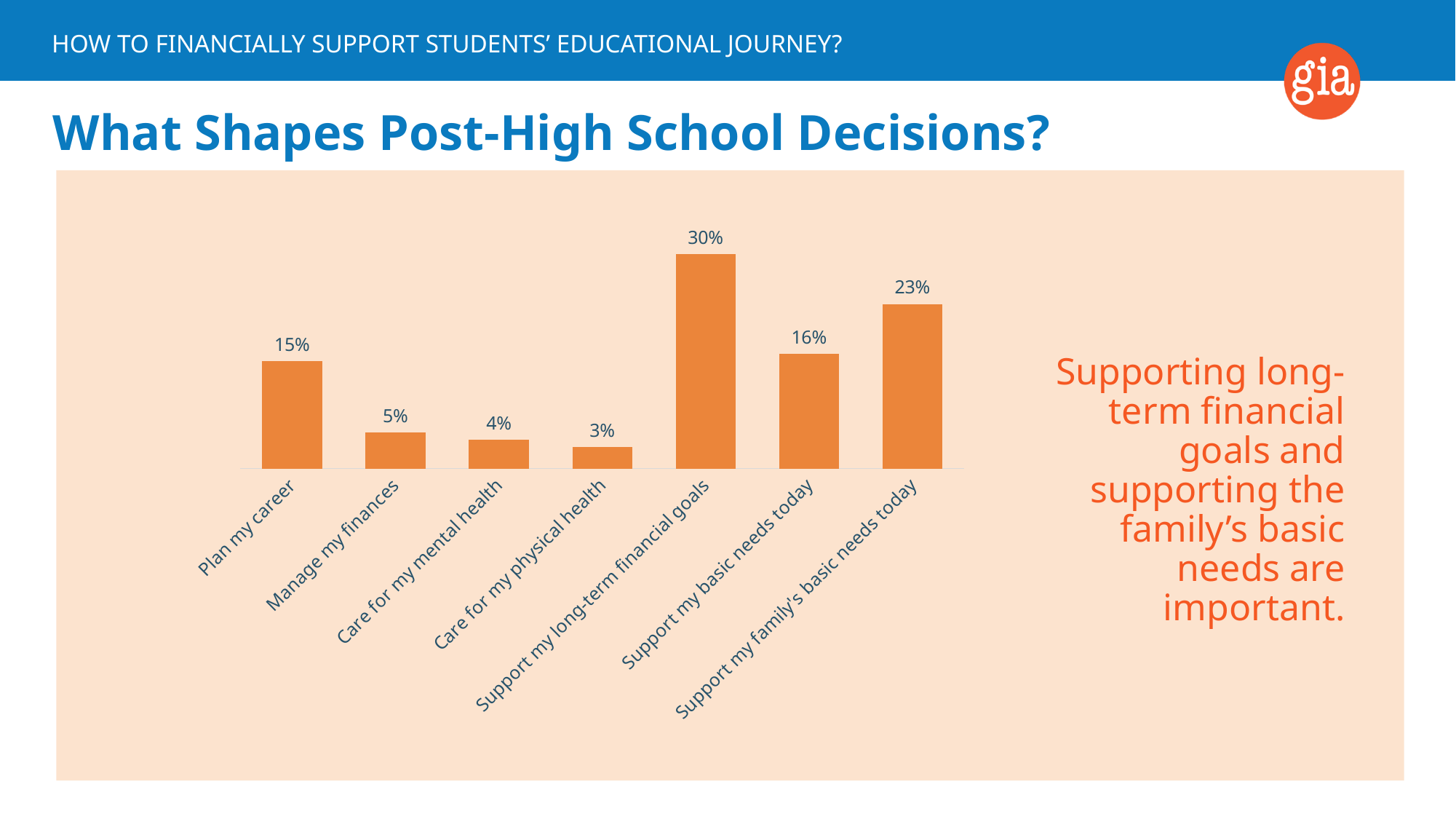
What is the value for "Care for my physical health"? 3% What is the value for "Support my family's basic needs today"? 23% What is the difference between "Support my long-term financial goals" and "Support my family's basic needs today"? 7% How many categories are shown in the chart? 7 What is the title of the slide above the chart? What Shapes Post-High School Decisions? What is the value for "Plan my career"? 15% Which category has the lowest value? Care for my physical health What is the difference between "Support my basic needs today" and "Plan my career"? 1% Which is larger, "Manage my finances" or "Care for my mental health"? Manage my finances Which category has the highest value? Support my long-term financial goals What kind of chart is shown on the slide? Bar chart What is the value for "Support my long-term financial goals"? 30%